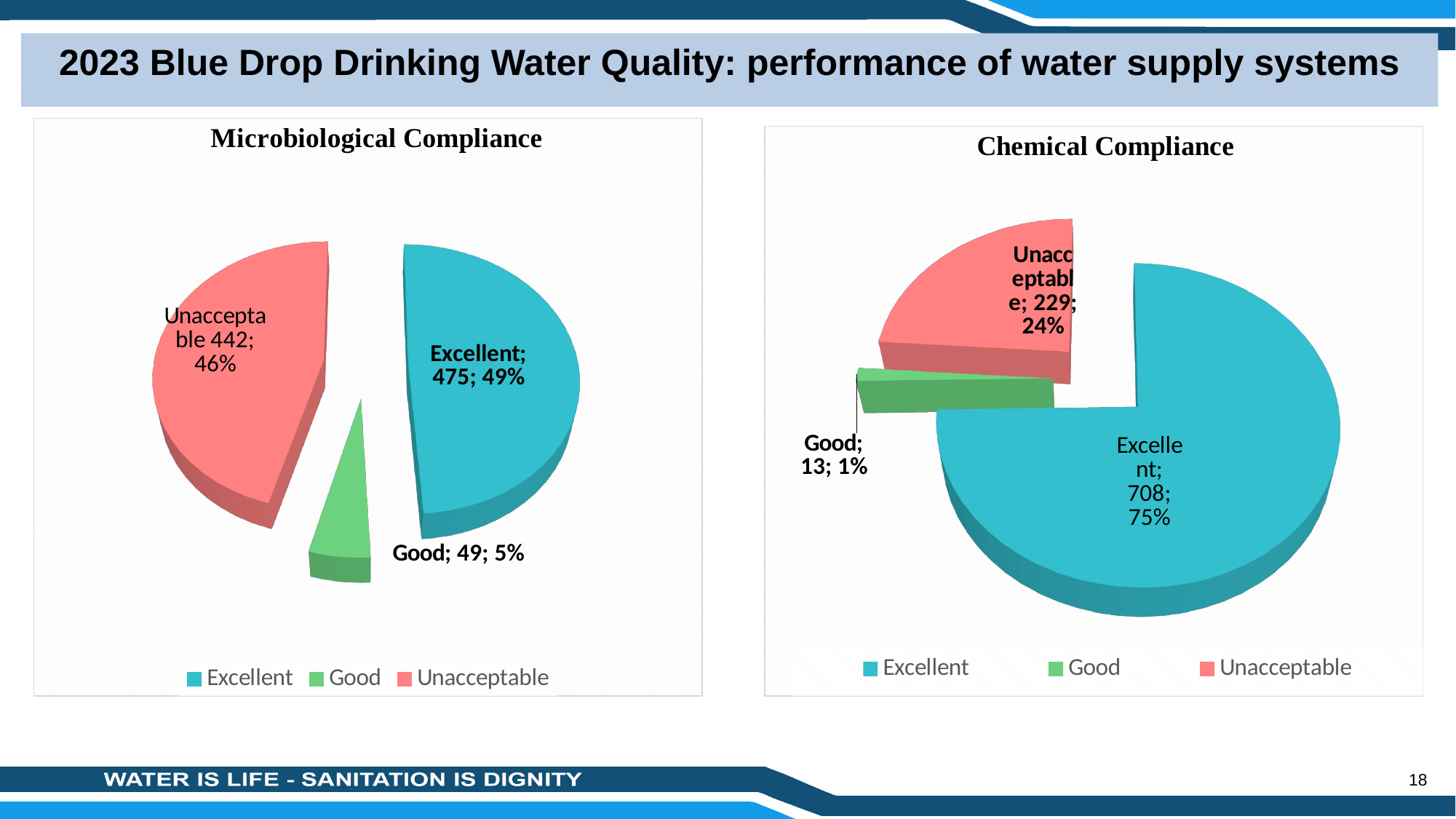
In the Microbiological Compliance chart, what is the value for Good? 49 In the Microbiological Compliance chart, what share of the pie is Unacceptable? 46% In the Chemical Compliance chart, is the value for Excellent or Unacceptable larger? Excellent In the Chemical Compliance chart, what is the value for Excellent? 708 How many categories does the legend of the Chemical Compliance chart list? 3 In the Microbiological Compliance chart, what is the value for Excellent? 475 What kind of chart is the Microbiological Compliance chart? Pie chart In the Microbiological Compliance chart, which category has the smallest slice? Good In the Microbiological Compliance chart, what is the difference between the Excellent and Unacceptable values? 33 In the Chemical Compliance chart, which category has the largest slice? Excellent In the Chemical Compliance chart, what share of the pie is Unacceptable? 24% In the Chemical Compliance chart, what is the value for Good? 13